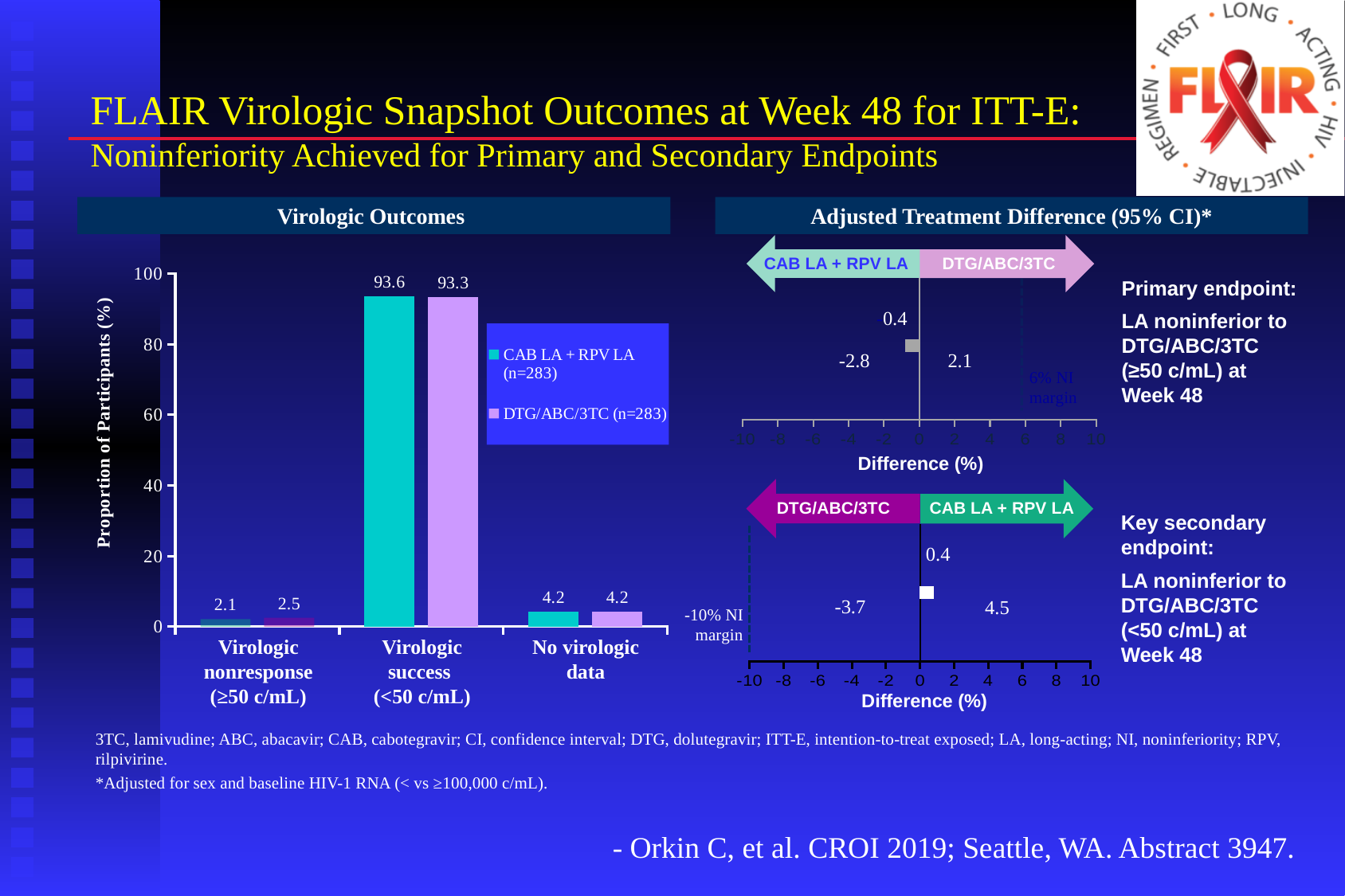
In the Adjusted Treatment Difference chart for the primary endpoint, what is the point estimate of the difference? -0.4 In the Virologic Outcomes chart, which series has the larger value for Virologic nonresponse (≥50 c/mL)? DTG/ABC/3TC In the Virologic Outcomes chart, which category has the highest values for both series? Virologic success (<50 c/mL) In the Virologic Outcomes chart, how many series does the legend list? 2 What kind of chart is the Virologic Outcomes chart? Bar chart In the Virologic Outcomes chart, what is the value for CAB LA + RPV LA in the Virologic success (<50 c/mL) category? 93.6 In the Virologic Outcomes chart, what is the value for DTG/ABC/3TC in the No virologic data category? 4.2 In the Virologic Outcomes chart, how many categories are shown on the x axis? 3 In the Adjusted Treatment Difference chart for the key secondary endpoint, what are the lower and upper limits of the 95% CI? -3.7 and 4.5 In the Virologic Outcomes chart, what is the value for DTG/ABC/3TC in the Virologic nonresponse (≥50 c/mL) category? 2.5 In the Virologic Outcomes chart, what is the y-axis label? Proportion of Participants (%) In the Virologic Outcomes chart, what is the difference between the CAB LA + RPV LA and DTG/ABC/3TC values for Virologic success (<50 c/mL)? 0.3